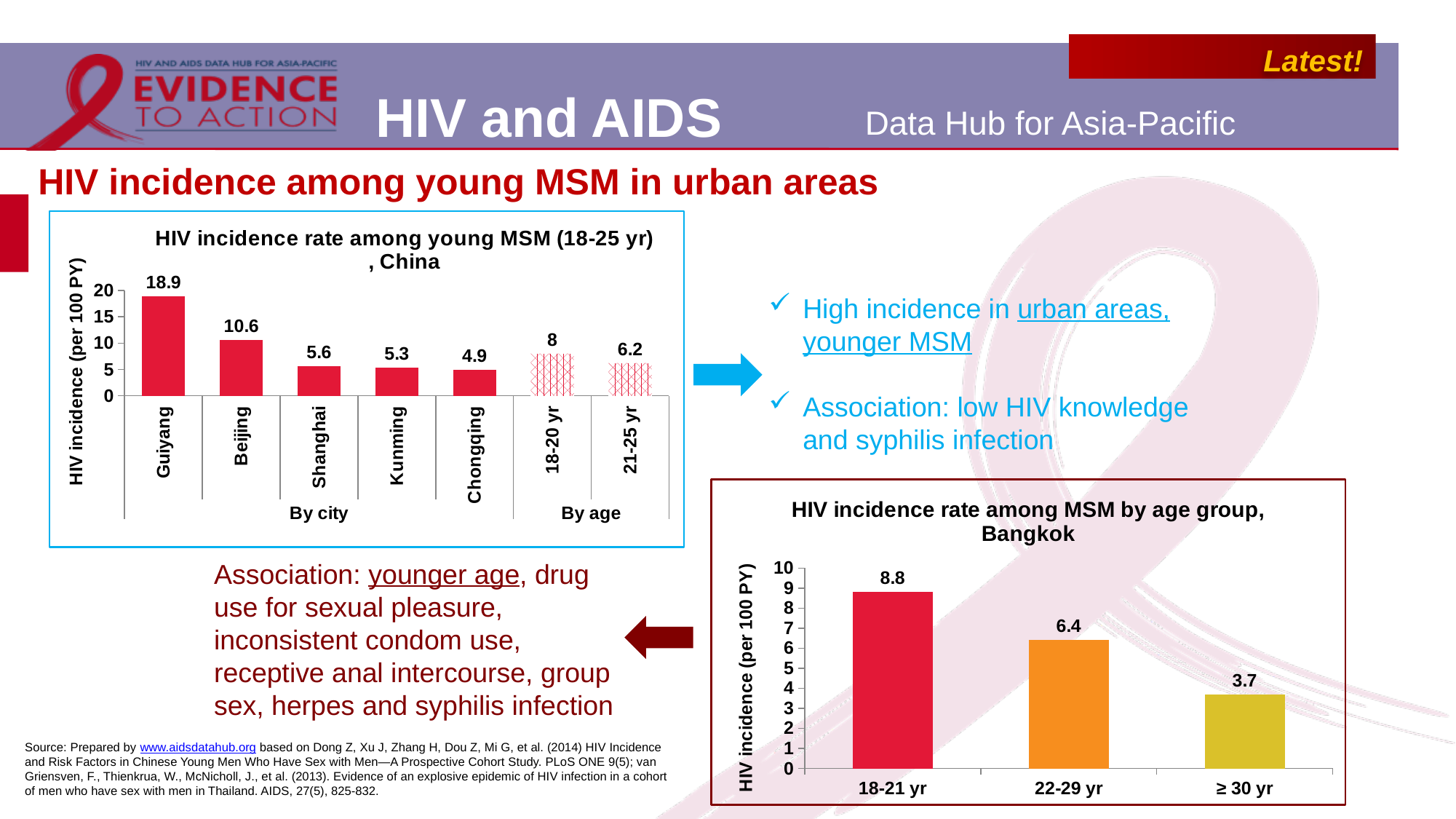
In the China chart, what is the HIV incidence rate for Guiyang? 18.9 In the Bangkok chart, do the HIV incidence rates rise or fall as age group increases along the x axis? fall In the China chart, what is the difference between the HIV incidence rates for Guiyang and Beijing? 8.3 In the Bangkok chart, what is the HIV incidence rate for the 22-29 yr age group? 6.4 In the China chart, how many cities are shown in the 'By city' group? 5 In the Bangkok chart, which age group has the lowest HIV incidence rate? ≥ 30 yr In the Bangkok chart, what is the difference between the HIV incidence rates for the 18-21 yr and ≥ 30 yr groups? 5.1 In the China chart, which category has the highest HIV incidence rate? Guiyang In the China chart, which has a higher HIV incidence rate, the 18-20 yr group or the 21-25 yr group? 18-20 yr In the China chart, which city has the lowest HIV incidence rate? Chongqing In the China chart, what is the HIV incidence rate for Beijing? 10.6 What type of chart is the Bangkok chart? bar chart